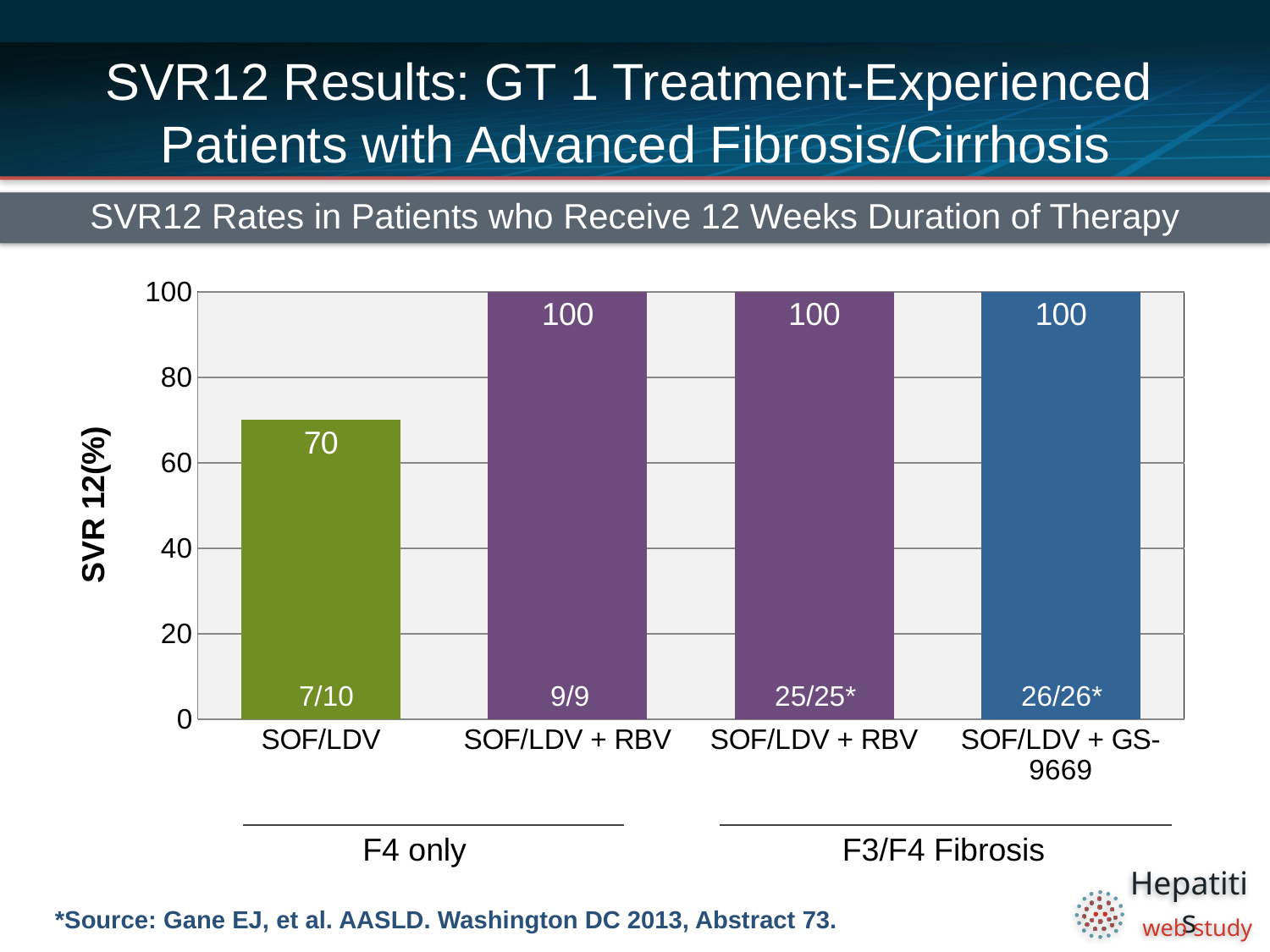
Which is larger, the SVR12 rate for SOF/LDV in the F4 only group or for SOF/LDV + RBV in the F4 only group? SOF/LDV + RBV Which bar has the lowest SVR12 rate? SOF/LDV (F4 only) How many bars are plotted in the chart? 4 What is the title shown above the chart? SVR12 Rates in Patients who Receive 12 Weeks Duration of Therapy What is the SVR12 rate for SOF/LDV + GS-9669 in the F3/F4 Fibrosis group? 100 What is the SVR12 rate for SOF/LDV in the F4 only group? 70 What is the difference in SVR12 rate between SOF/LDV + RBV in the F4 only group and SOF/LDV in the F4 only group? 30 What fraction of patients is shown for the SOF/LDV bar in the F4 only group? 7/10 What kind of chart is shown on the slide? Bar chart What fraction of patients is shown for the SOF/LDV + RBV bar in the F3/F4 Fibrosis group? 25/25* What is the label of the y axis? SVR 12(%) What fraction of patients is shown for the SOF/LDV + GS-9669 bar? 26/26*